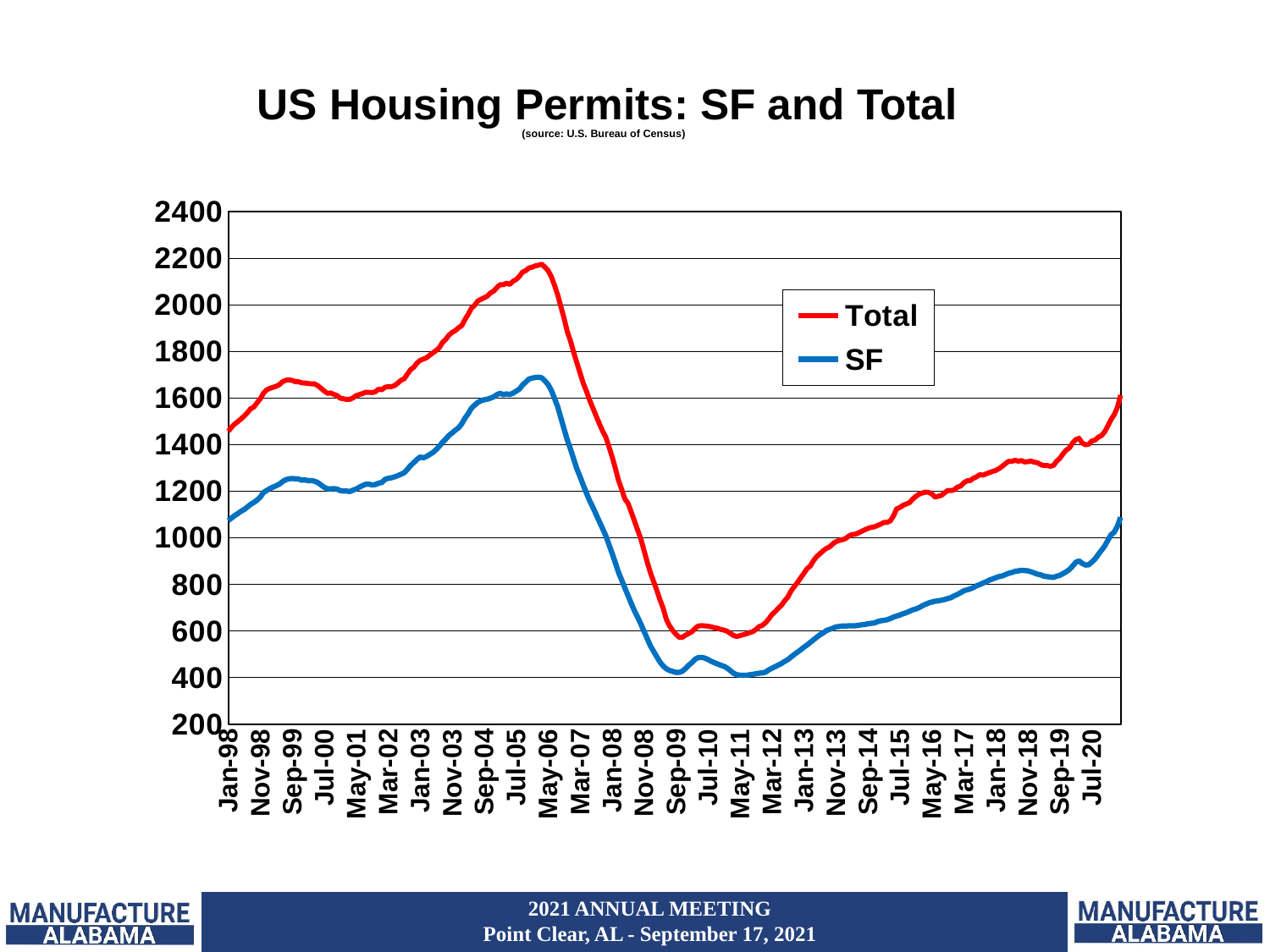
Is the value of the SF series at Jan-98 greater or less than 1000? greater Which series has the larger value at May-06, Total or SF? Total Which colour is used for the Total series? red Does the SF series rise or fall between May-11 and Jul-20? rise Is the value of the SF series at its low point around May-11 greater or less than 600? less Is the value of the SF series at its peak around May-06 greater or less than 1600? greater How many series does the legend list? 2 Does the Total series rise or fall between May-06 and Sep-09? fall What kind of chart is shown on the slide? line chart What is the title of the chart? US Housing Permits: SF and Total